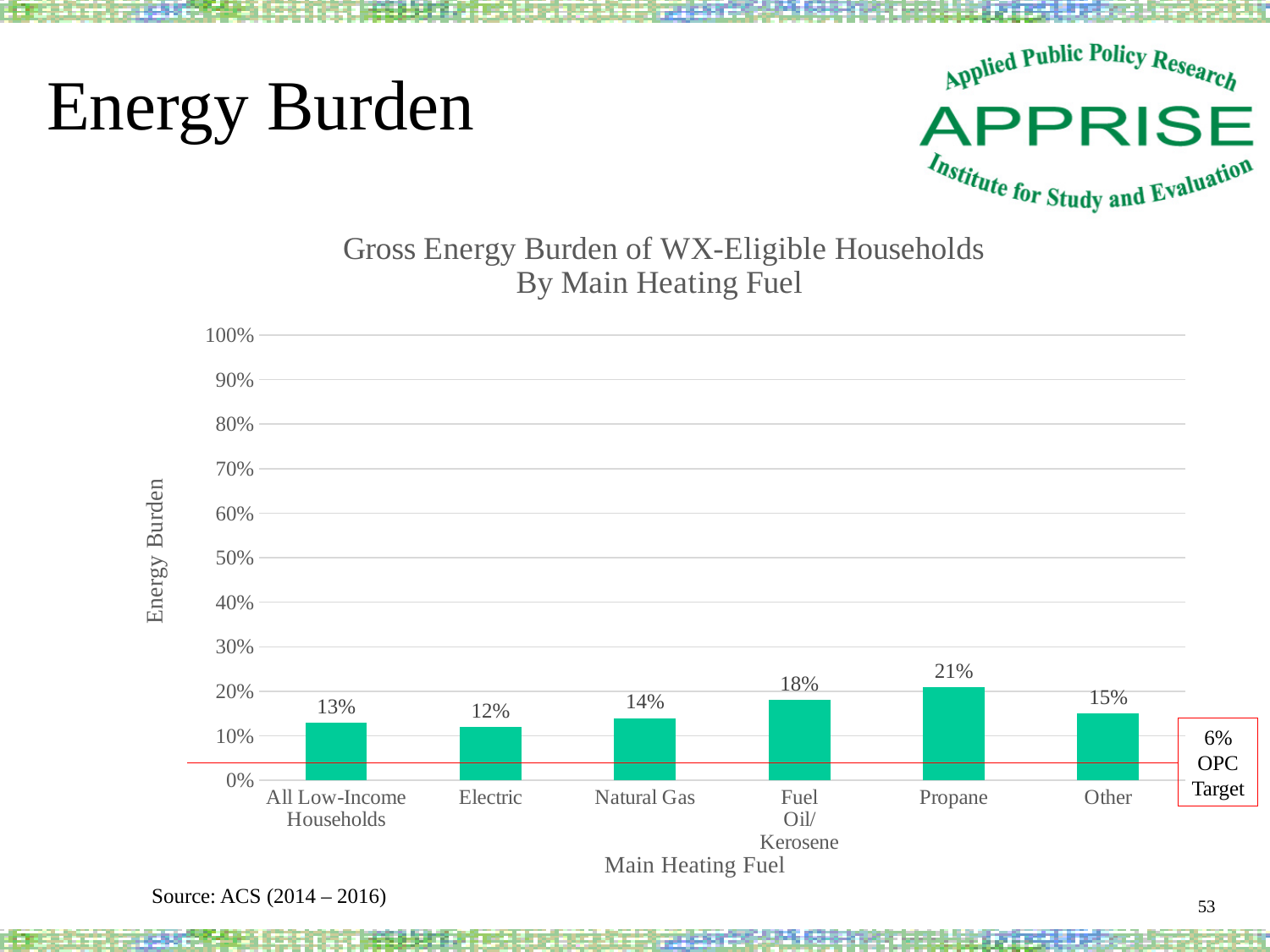
What is the difference in energy burden between Fuel Oil/Kerosene and Natural Gas households? 4% What is the gross energy burden for Propane households? 21% What type of chart is used to show gross energy burden by main heating fuel? Bar chart What is the difference in energy burden between Propane and Electric households? 9% What is the gross energy burden for All Low-Income Households? 13% What is the OPC Target energy burden shown on the chart? 6% How many main heating fuel categories are shown in the chart? 6 What is the label of the y-axis? Energy Burden Which main heating fuel has the lowest gross energy burden? Electric Which main heating fuel has the highest gross energy burden? Propane What is the gross energy burden for Electric households? 12% Which has a higher energy burden, Other or Natural Gas? Other